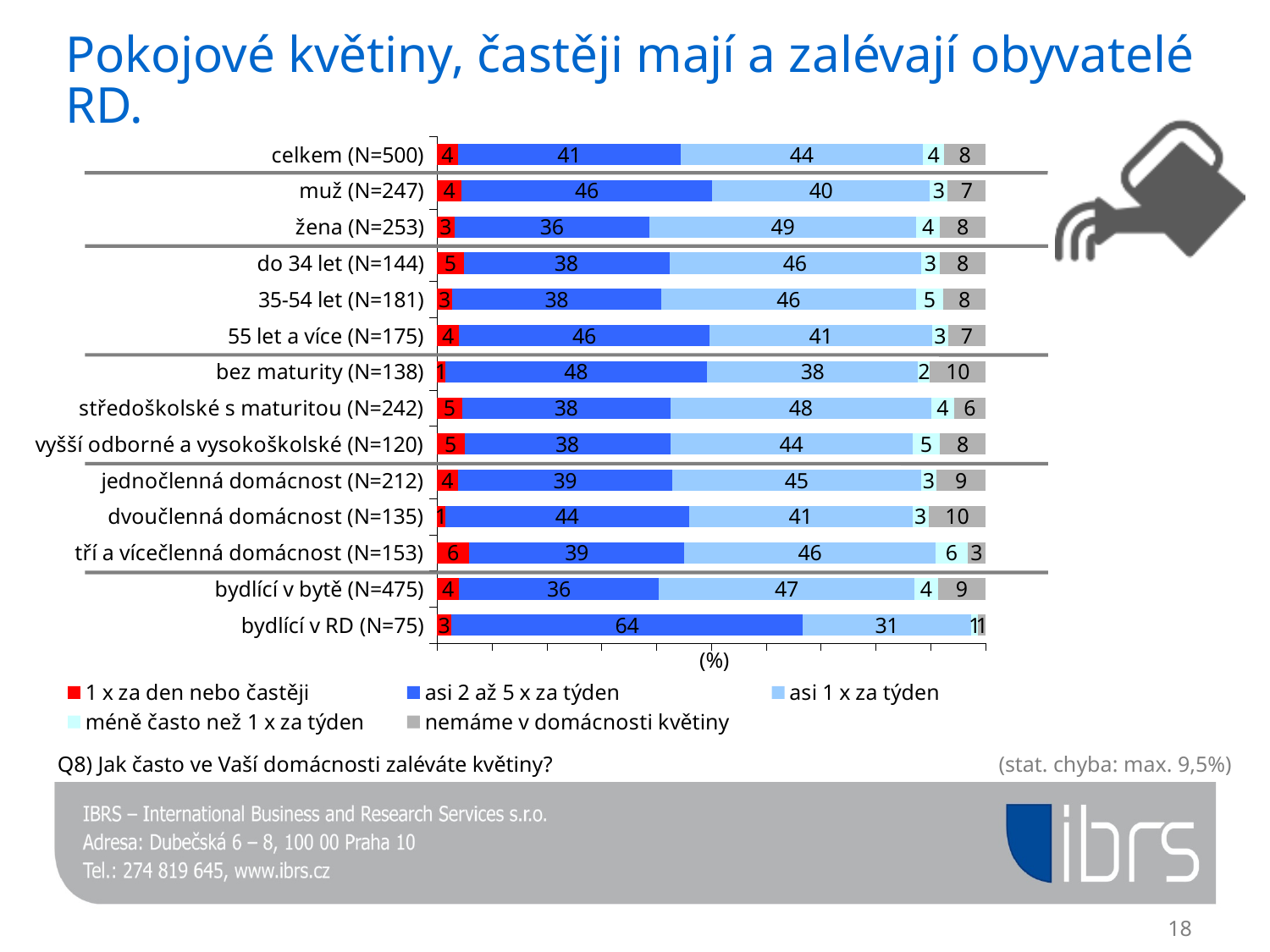
What is the difference between the 'asi 2 až 5 x za týden' values for 'bydlící v RD (N=75)' and 'bydlící v bytě (N=475)'? 28 What is the value of 'nemáme v domácnosti květiny' for 'bez maturity (N=138)'? 10 Which is larger: the 'asi 1 x za týden' value for 'muž (N=247)' or for 'žena (N=253)'? žena (N=253) Which category has the lowest value for 'nemáme v domácnosti květiny'? bydlící v RD (N=75) What is the value of 'asi 2 až 5 x za týden' for 'bydlící v RD (N=75)'? 64 What is the total of the stacked bar for 'muž (N=247)'? 100 How many series does the legend list? 5 Which legend entry is shown in red? 1 x za den nebo častěji What kind of chart is shown on the slide? stacked bar chart Which category has the highest value for 'asi 2 až 5 x za týden'? bydlící v RD (N=75) How many categories (rows) are plotted in the chart? 14 What is the value of 'asi 1 x za týden' for 'žena (N=253)'? 49